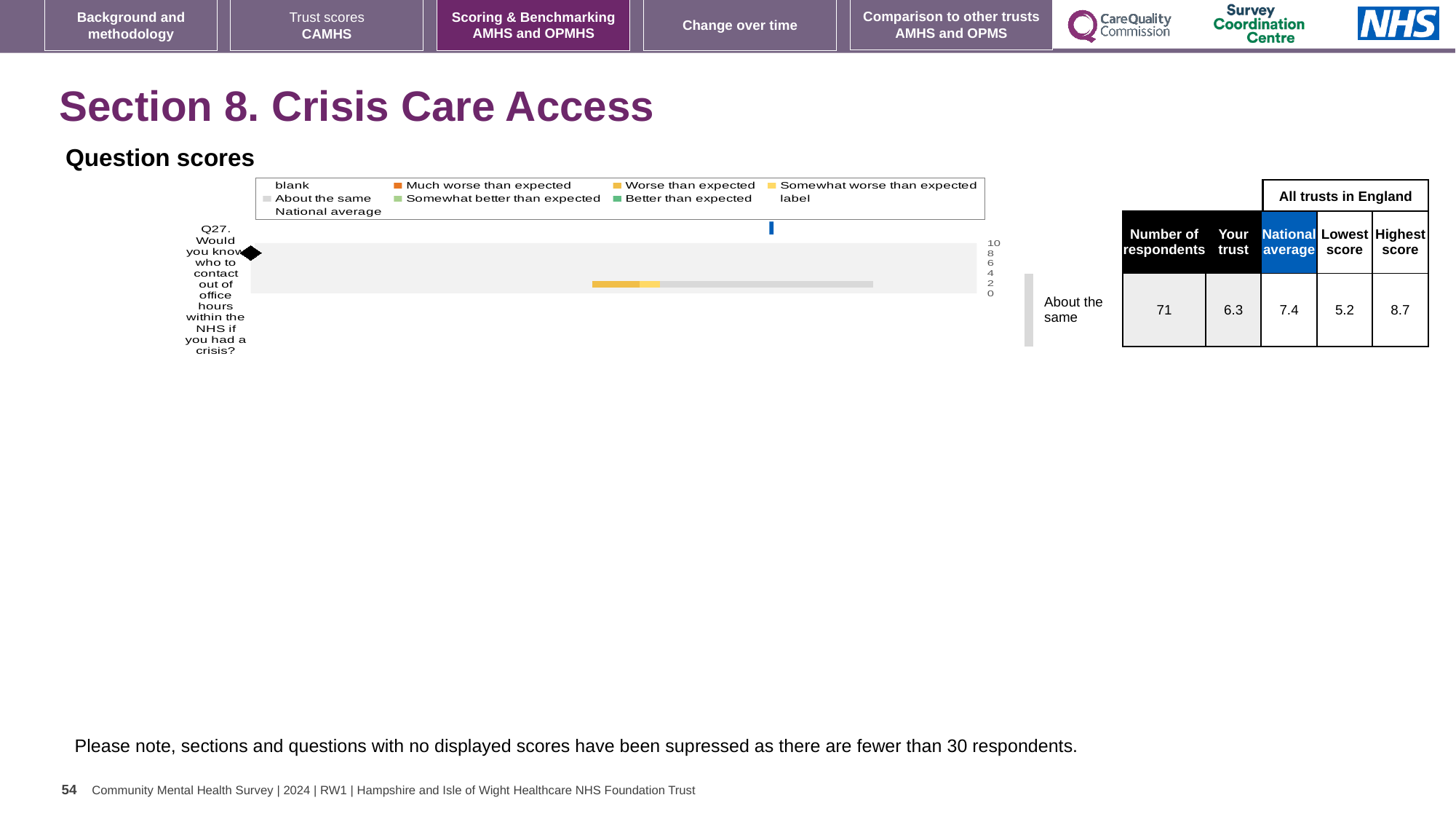
How many survey questions are plotted in the 'Question scores' chart? 1 In the legend of the 'Question scores' chart, what colour represents 'Much worse than expected'? Orange For Q27, which is larger: the 'Your trust' score or the national average? National average What kind of chart is shown under 'Question scores'? bar chart What benchmark category label is shown next to the Q27 bar in the 'Question scores' chart? About the same For Q27, what is the difference between the highest score and the lowest score among all trusts in England? 3.5 In the table beside the 'Question scores' chart, what is the highest score among all trusts in England for Q27? 8.7 In the table beside the 'Question scores' chart, how many respondents answered Q27? 71 In the table beside the 'Question scores' chart, what is the national average score for Q27? 7.4 In the table beside the 'Question scores' chart, what is the lowest score among all trusts in England for Q27? 5.2 For Q27, what is the difference between the national average and the 'Your trust' score? 1.1 In the table beside the 'Question scores' chart, what is the 'Your trust' score for Q27? 6.3